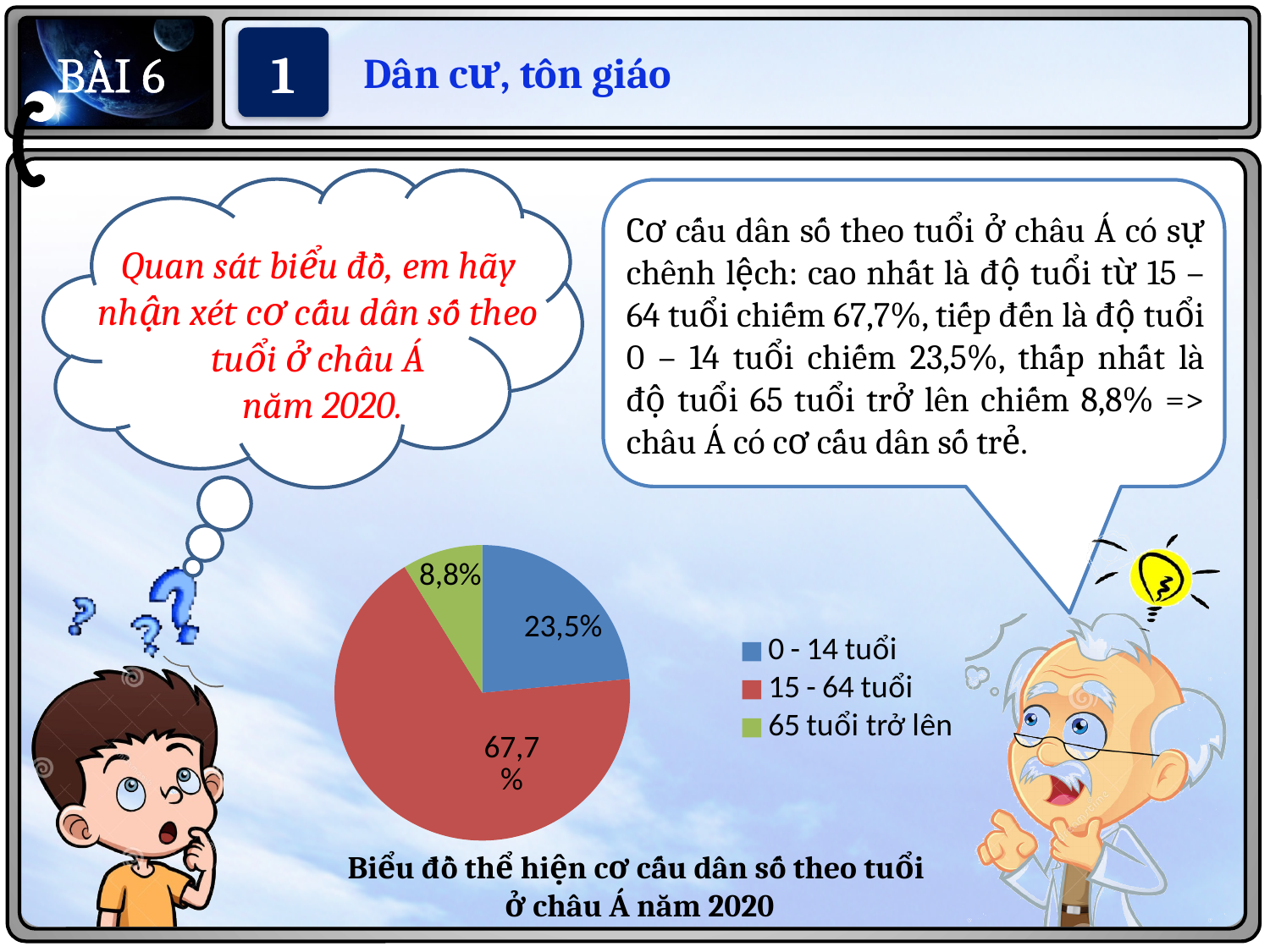
What share of the pie does the 0 - 14 tuổi group have? 23,5% Which age group has the smallest share of the pie? 65 tuổi trở lên How many slices does the pie chart have? 3 What share of the pie does the 15 - 64 tuổi group have? 67,7% What is the title of the pie chart? Biểu đồ thể hiện cơ cấu dân số theo tuổi ở châu Á năm 2020 What is the difference in percentage points between the 15 - 64 tuổi share and the 0 - 14 tuổi share? 44,2 Which age group has the largest share of the pie? 15 - 64 tuổi What kind of chart is shown on the slide? pie chart What is the difference in percentage points between the 0 - 14 tuổi share and the 65 tuổi trở lên share? 14,7 Which is larger: the share for 0 - 14 tuổi or the share for 65 tuổi trở lên? 0 - 14 tuổi What share of the pie does the 65 tuổi trở lên group have? 8,8% What colour is the slice for 15 - 64 tuổi? red